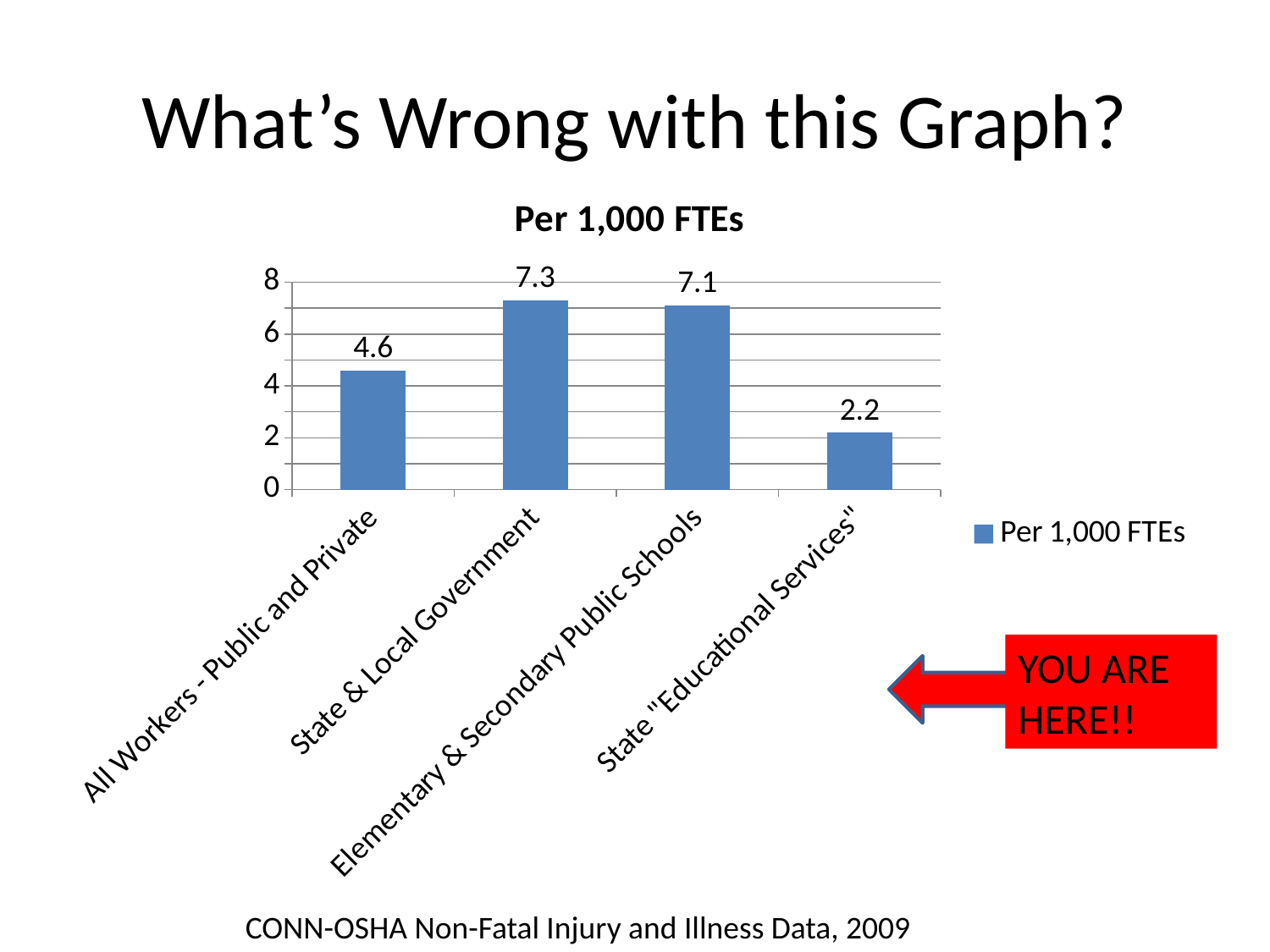
Which category has the lowest value? State "Educational Services" How many categories are shown on the chart? 4 What is the difference between the values for State & Local Government and State "Educational Services"? 5.1 What is the value for State "Educational Services"? 2.2 Which is larger, the value for All Workers - Public and Private or the value for Elementary & Secondary Public Schools? Elementary & Secondary Public Schools How many series does the legend list? 1 What is the value for Elementary & Secondary Public Schools? 7.1 What is the title of the chart? Per 1,000 FTEs What is the value for All Workers - Public and Private? 4.6 Which category has the highest value? State & Local Government What kind of chart is shown on the slide? bar chart What is the value for State & Local Government? 7.3